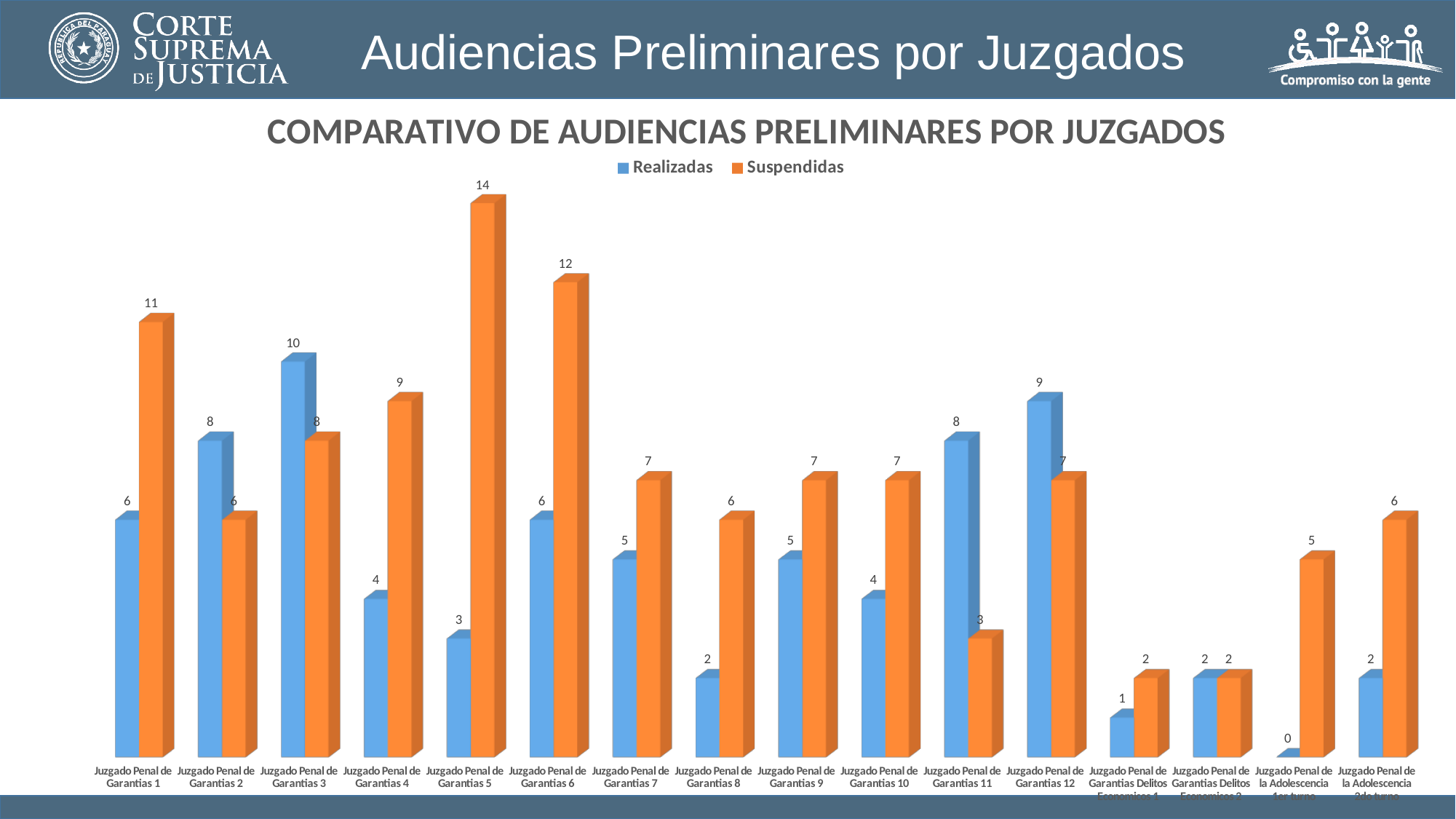
For Juzgado Penal de Garantias 12, which is larger, Realizadas or Suspendidas? Realizadas Which juzgado has the highest Suspendidas value? Juzgado Penal de Garantias 5 What is the difference between Suspendidas and Realizadas for Juzgado Penal de Garantias 1? 5 Which juzgado has the highest Realizadas value? Juzgado Penal de Garantias 3 What type of chart is shown on the slide? bar chart What is the Realizadas value for Juzgado Penal de Garantias 3? 10 How many juzgados (categories) are shown on the x axis? 16 What is the title of the chart? COMPARATIVO DE AUDIENCIAS PRELIMINARES POR JUZGADOS How many series does the legend list? 2 What is the difference between Suspendidas and Realizadas for Juzgado Penal de Garantias 6? 6 What is the Realizadas value for Juzgado Penal de Garantias 11? 8 What is the Suspendidas value for Juzgado Penal de Garantias 5? 14